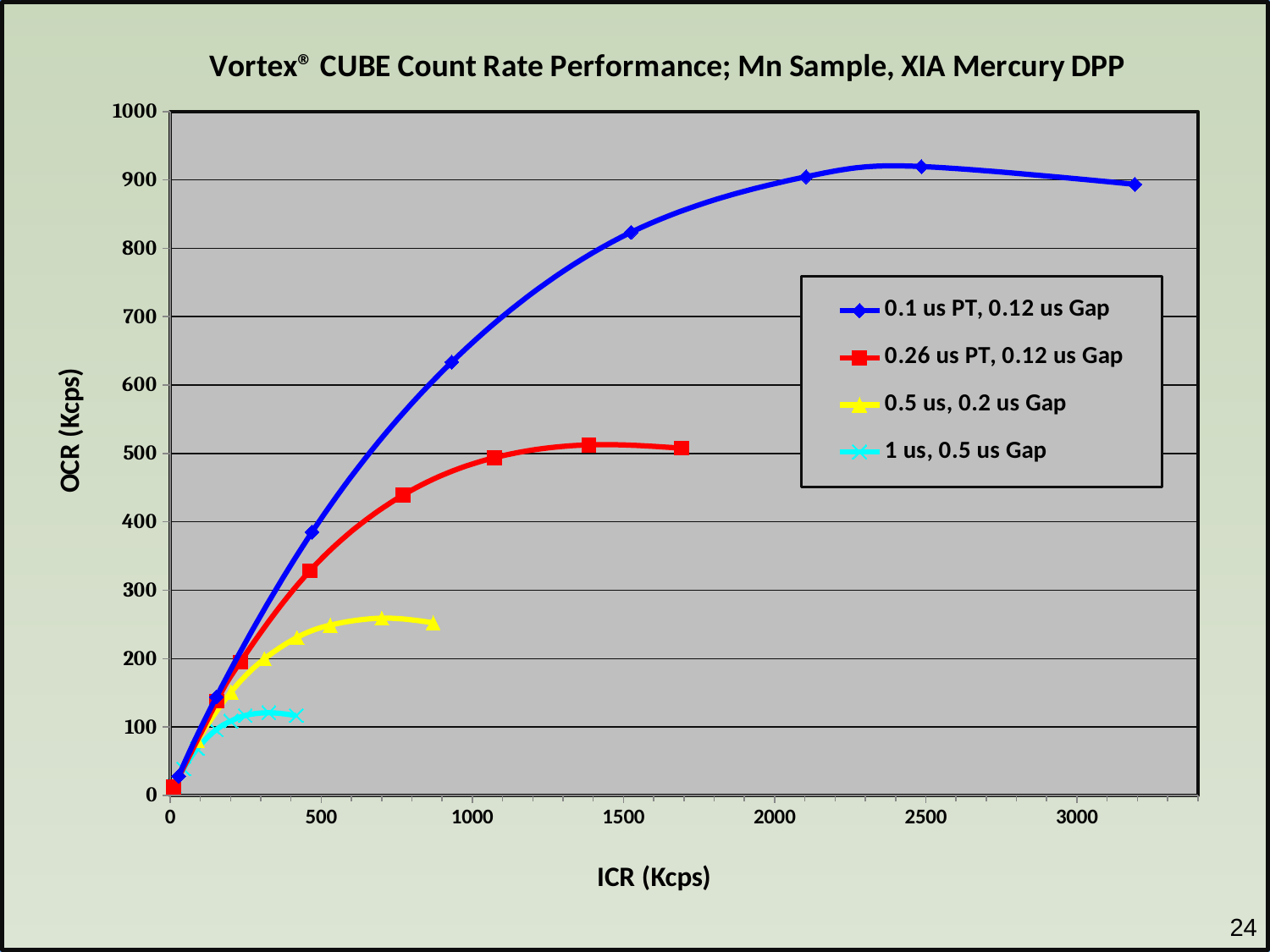
What is the label of the x axis? ICR (Kcps) Which series has the lowest peak OCR value? 1 us, 0.5 us Gap Is the peak OCR value for the "0.5 us, 0.2 us Gap" series greater or less than 300? less How many series does the legend list? 4 Which series reaches a higher OCR, "0.26 us PT, 0.12 us Gap" or "0.5 us, 0.2 us Gap"? 0.26 us PT, 0.12 us Gap Is the peak OCR value for the "1 us, 0.5 us Gap" series greater or less than 200? less Is the peak OCR value for the "0.1 us PT, 0.12 us Gap" series greater or less than 800? greater What is the title of the chart? Vortex® CUBE Count Rate Performance; Mn Sample, XIA Mercury DPP Does the OCR of the "0.1 us PT, 0.12 us Gap" series rise or fall as ICR increases from 0 to 2000? rise Which series reaches the highest OCR value? 0.1 us PT, 0.12 us Gap What kind of chart is shown on the slide? line chart